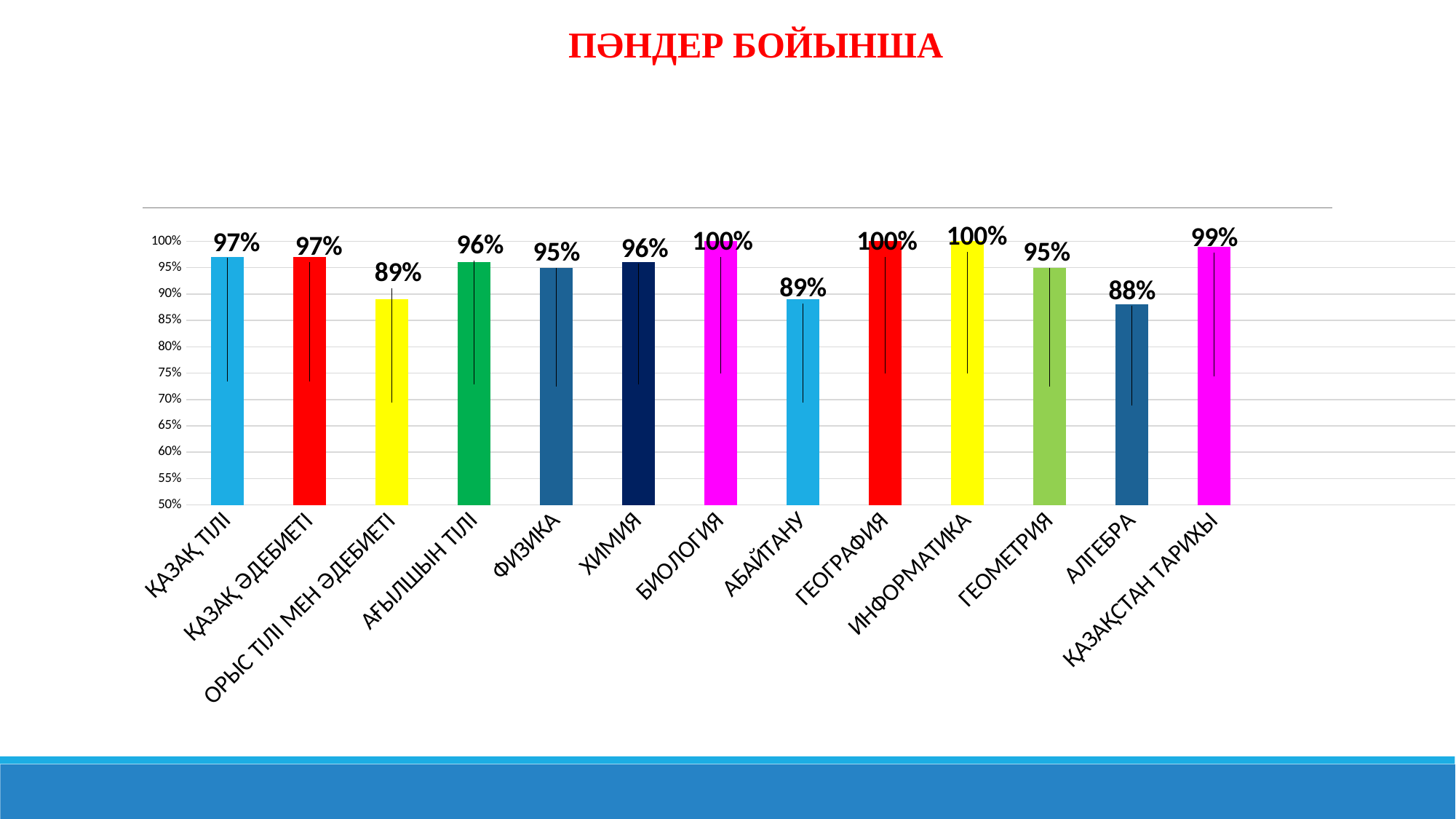
What is the value for ҚАЗАҚСТАН ТАРИХЫ? 99% What is the value for ОРЫС ТІЛІ МЕН ӘДЕБИЕТІ? 89% What is the title of the slide? ПӘНДЕР БОЙЫНША What is the difference between the values for БИОЛОГИЯ and АБАЙТАНУ? 11% How many categories are shown in the chart? 13 What kind of chart is shown on the slide? bar chart What is the difference between the values for ҚАЗАҚ ТІЛІ and ФИЗИКА? 2% What is the value for ХИМИЯ? 96% Which is larger, the value for ГЕОМЕТРИЯ or the value for ҚАЗАҚСТАН ТАРИХЫ? ҚАЗАҚСТАН ТАРИХЫ What is the value for АЛГЕБРА? 88% Is the value for АБАЙТАНУ greater or less than 90%? less Which category has the lowest value? АЛГЕБРА